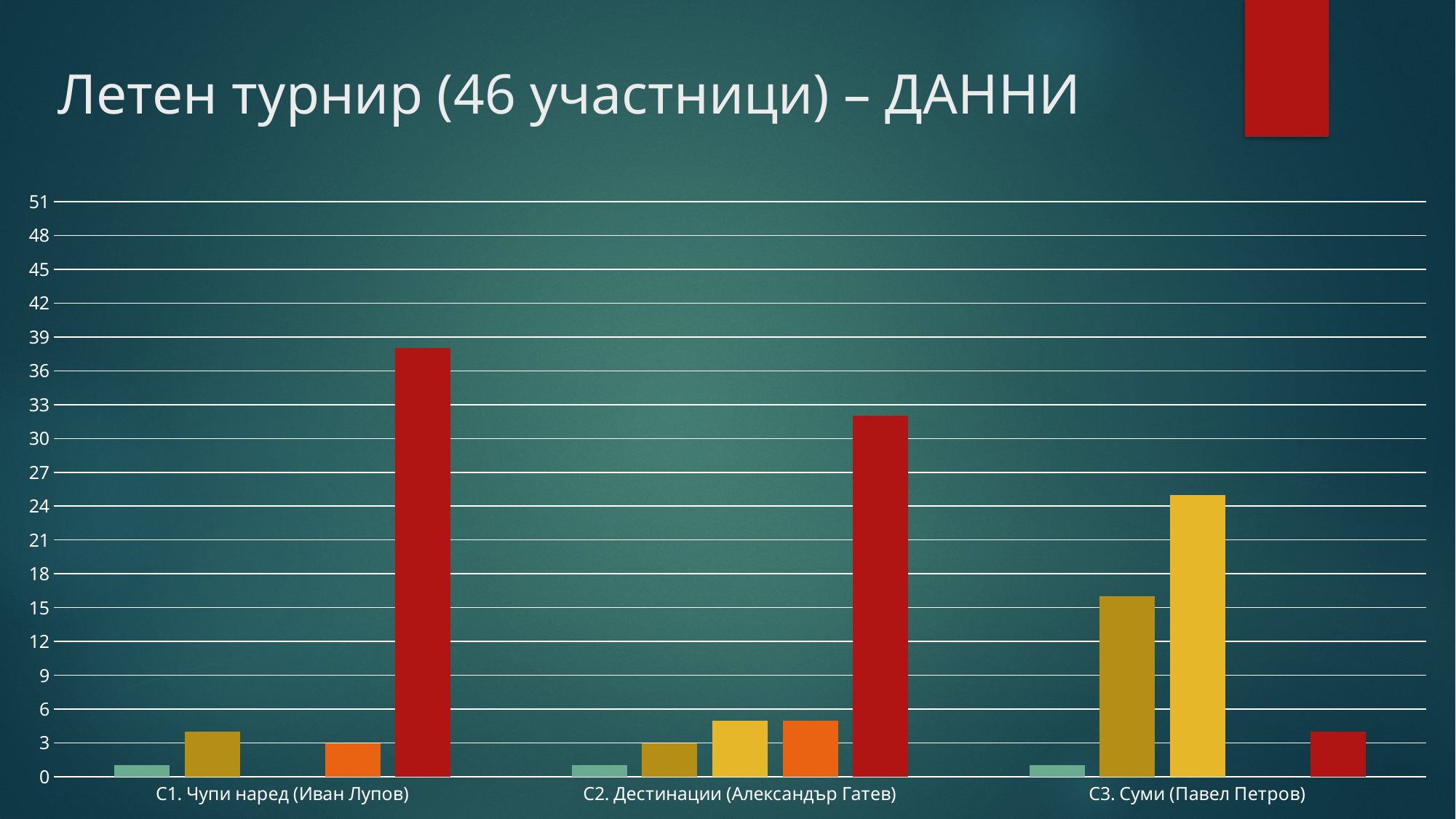
Is the value of the red bar for С2. Дестинации (Александър Гатев) greater or less than 30? greater How many categories are shown on the x axis of the chart? 3 Is the value of the yellow bar for С3. Суми (Павел Петров) greater or less than 24? greater What is the value of the orange bar for С1. Чупи наред (Иван Лупов)? 3 Which is larger: the red bar for С1. Чупи наред (Иван Лупов) or the red bar for С2. Дестинации (Александър Гатев)? С1. Чупи наред (Иван Лупов) Which category contains the tallest bar in the chart? С1. Чупи наред (Иван Лупов) Which bar is the tallest within the category С3. Суми (Павел Петров)? the yellow bar What is the title of the slide containing the chart? Летен турнир (46 участници) – ДАННИ Is the value of the red bar for С3. Суми (Павел Петров) greater or less than 6? less What colour is the tallest bar in the chart? red What kind of chart is shown on the slide? bar chart